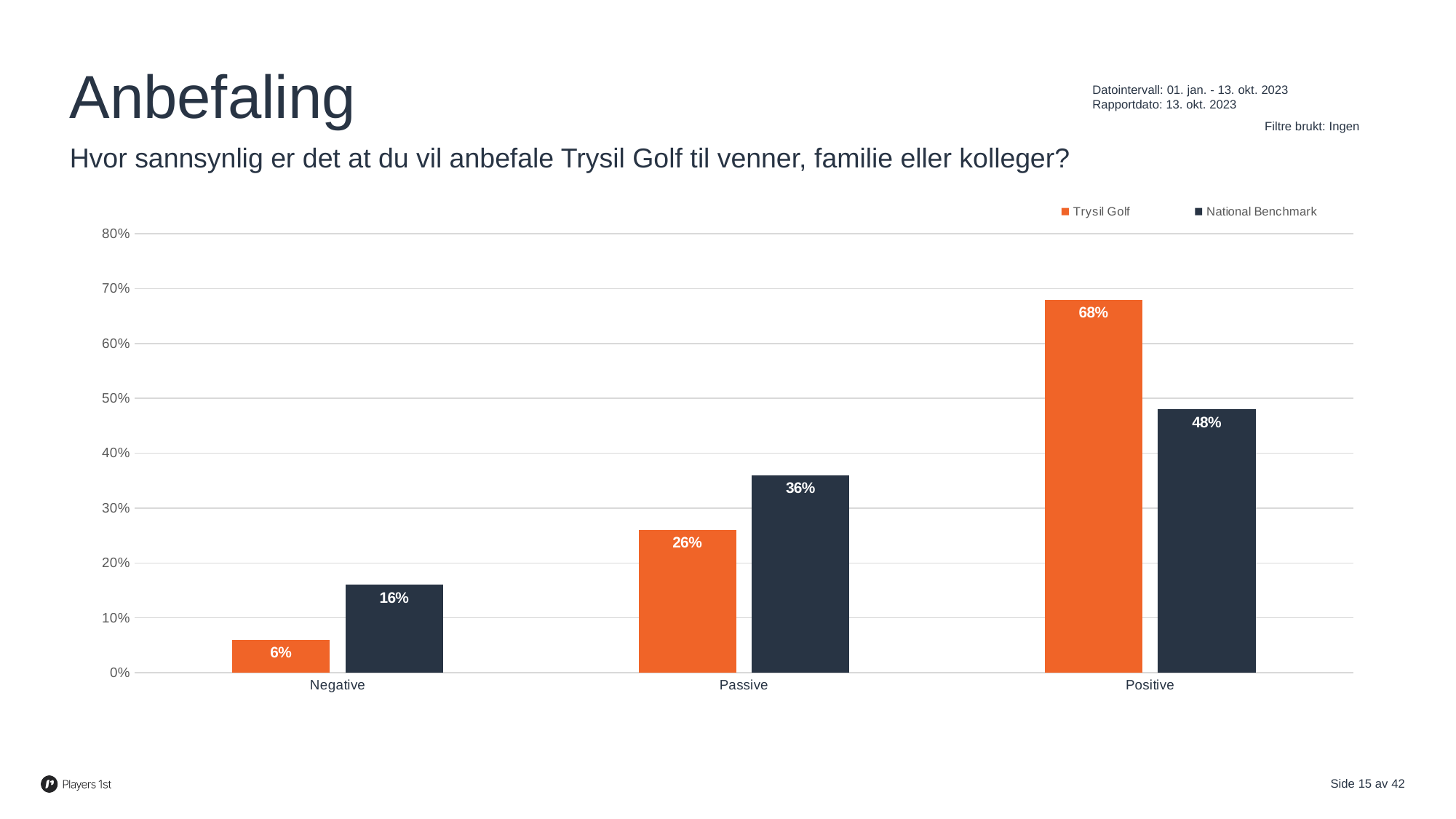
Which is larger for Passive: Trysil Golf or National Benchmark? National Benchmark How many series does the legend list? 2 Which category has the highest Trysil Golf value? Positive What is the National Benchmark value for Negative? 16% What is the National Benchmark value for Passive? 36% What is the Trysil Golf value for Positive? 68% What kind of chart is shown on the slide? Bar chart How many categories are shown on the x axis? 3 What is the Trysil Golf value for Negative? 6% What is the difference between the Trysil Golf and National Benchmark values for Positive? 20% Which colour represents Trysil Golf in the chart? Orange Which category has the lowest National Benchmark value? Negative